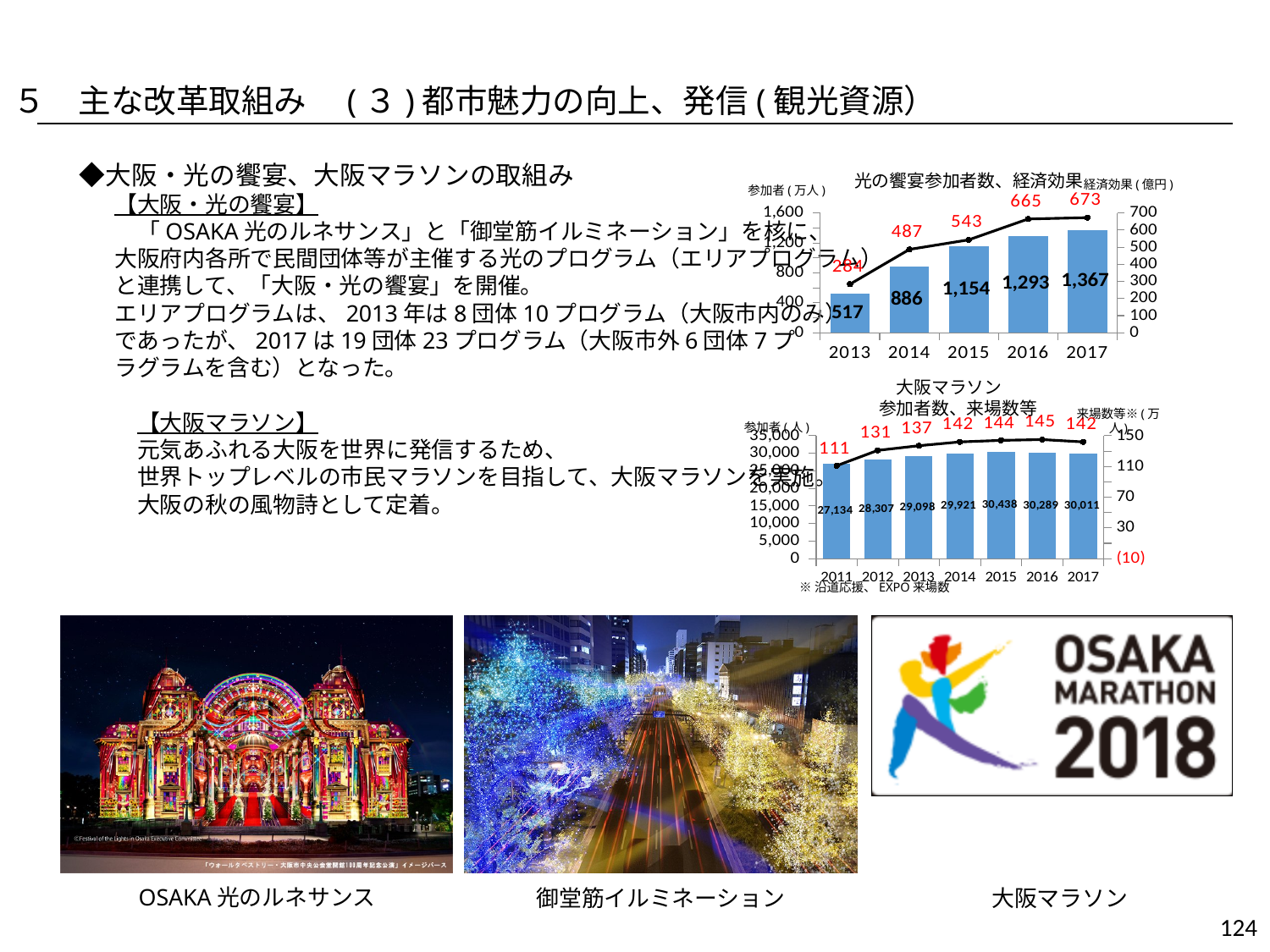
In the 大阪マラソン 参加者数、来場数等 chart, what is the line value for 2011? 111 In the 光の饗宴参加者数、経済効果 chart, do the economic effect line values rise or fall from 2013 to 2017? rise In the 光の饗宴参加者数、経済効果 chart, what is the economic effect (line) value for 2016? 665 In the 光の饗宴参加者数、経済効果 chart, which year has the highest participant bar? 2017 In the 大阪マラソン 参加者数、来場数等 chart, which is larger, the participant value for 2016 or for 2017? 2016 In the 光の饗宴参加者数、経済効果 chart, how many years are shown on the x axis? 5 In the 大阪マラソン 参加者数、来場数等 chart, how many years are shown on the x axis? 7 In the 大阪マラソン 参加者数、来場数等 chart, what is the participant (bar) value for 2015? 30,438 In the 光の饗宴参加者数、経済効果 chart, what is the difference between the participant values for 2014 and 2013? 369 What kind of chart is the 大阪マラソン 参加者数、来場数等 chart? Combined bar and line chart In the 大阪マラソン 参加者数、来場数等 chart, which year has the lowest participant bar? 2011 In the 光の饗宴参加者数、経済効果 chart, what is the participant (bar) value for 2015? 1,154